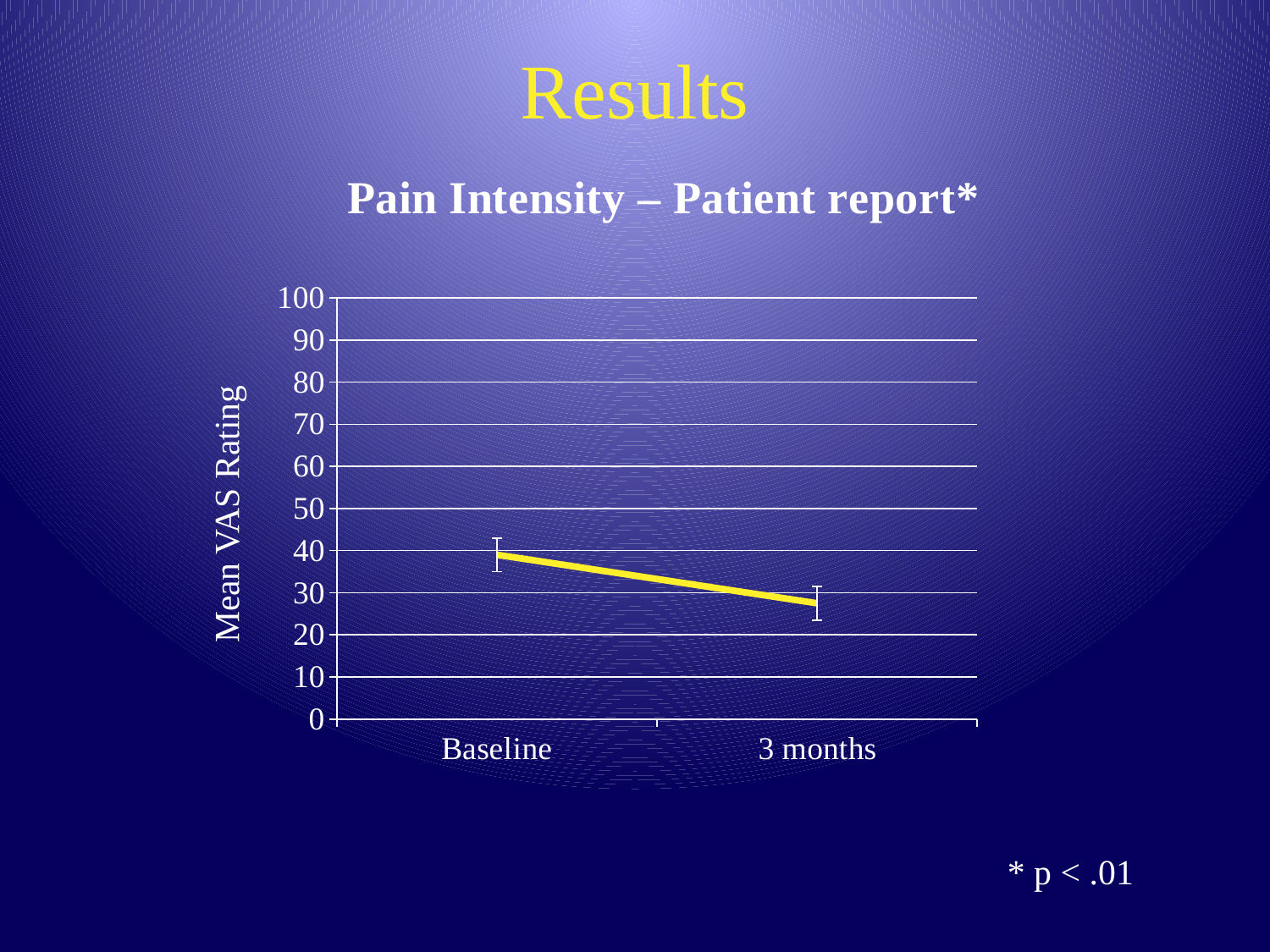
Which category has the higher Mean VAS Rating, Baseline or 3 months? Baseline Is the value for 3 months greater or less than 40? less What are the two categories on the x axis? Baseline and 3 months How many categories are plotted on the x axis? 2 What kind of chart is shown on the slide? line chart Is the value for Baseline greater or less than 50? less Is the value for Baseline greater or less than 30? greater What is the label of the y axis? Mean VAS Rating Which category has the lowest Mean VAS Rating? 3 months Which category has the highest Mean VAS Rating? Baseline Do the values rise or fall from Baseline to 3 months? fall